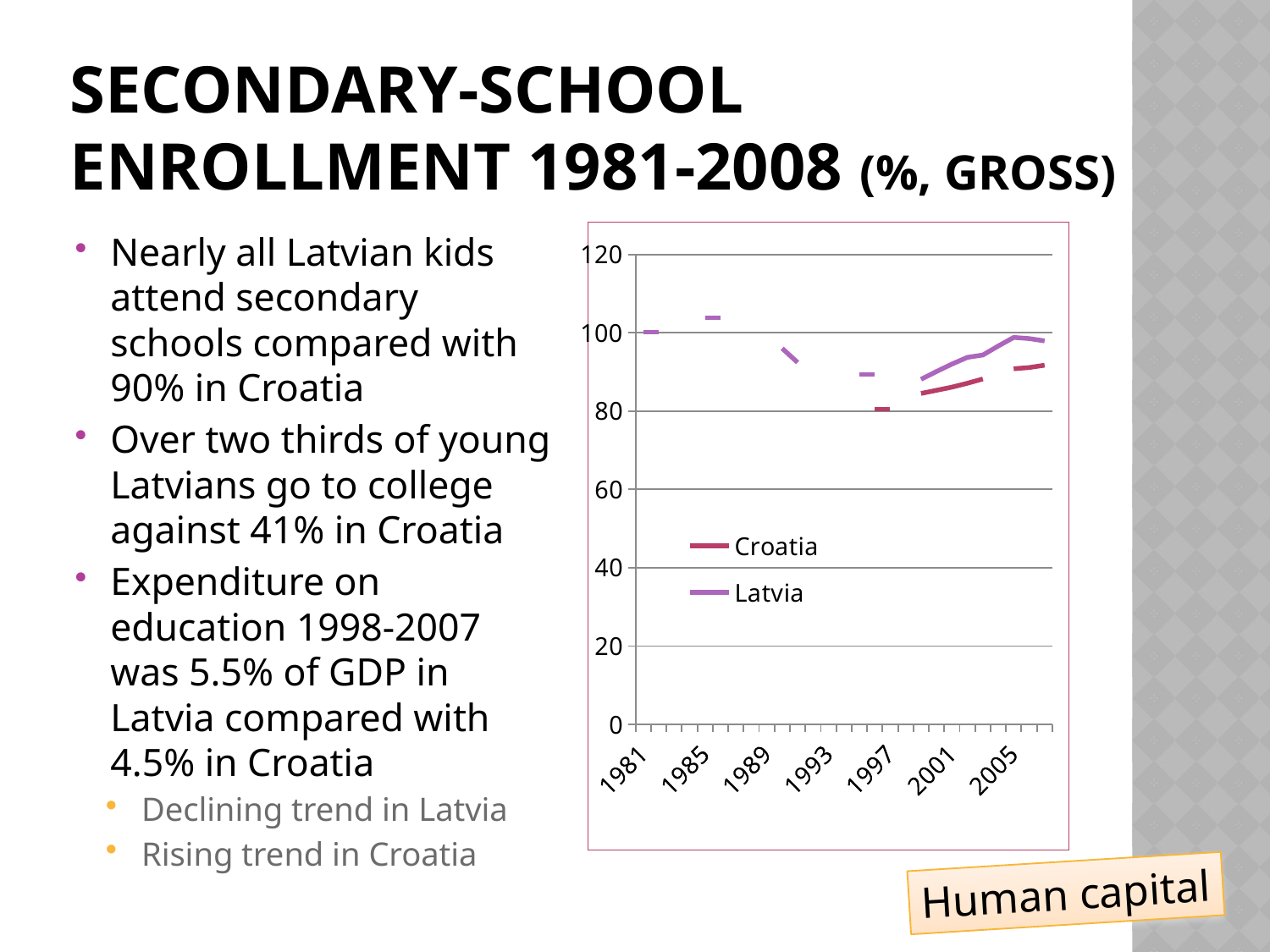
Is the value for Latvia in 1985 greater or less than 100? greater In 2005, which country has the higher value, Croatia or Latvia? Latvia What is the highest value shown on the chart's vertical axis? 120 What kind of chart is shown on the slide? line chart What colour is the Latvia line in the chart? purple Is the value for Croatia in 2001 greater or less than 80? greater Does the Croatia line rise or fall from 1997 to 2008? rise Which two countries are shown in the chart's legend? Croatia and Latvia How many series does the chart's legend list? 2 Does the Latvia line rise or fall from 1985 to 1997? fall Is the value for Croatia in 2001 greater or less than 100? less